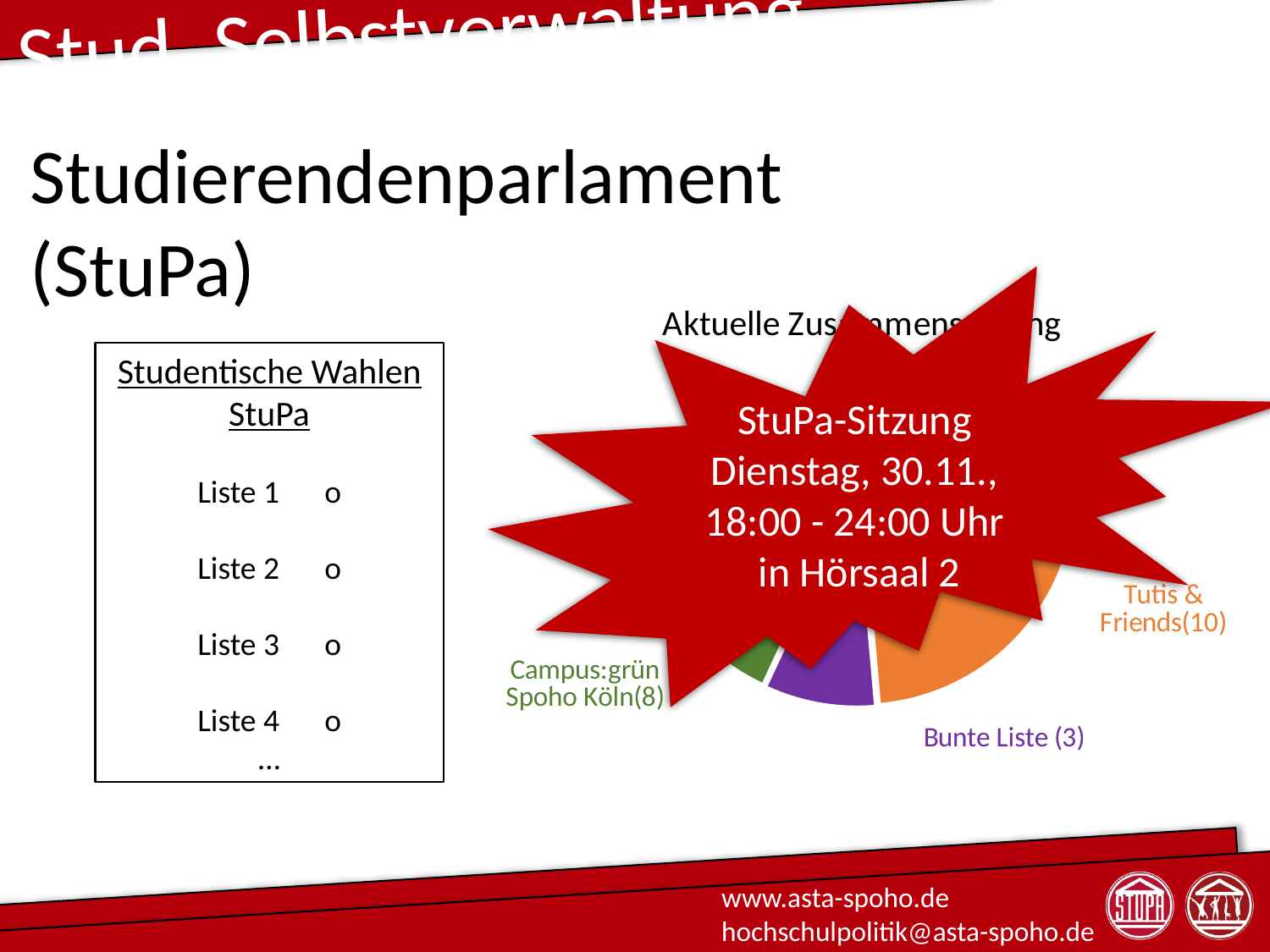
What is the difference in seats between Campus:grün Spoho Köln and Bunte Liste? 5 How many seats does the label for Tutis & Friends show? 10 Which has more seats, Tutis & Friends or Bunte Liste? Tutis & Friends Which has more seats, Campus:grün Spoho Köln or Bunte Liste? Campus:grün Spoho Köln What kind of chart is shown on the slide? doughnut chart How many seats does the label for Campus:grün Spoho Köln show? 8 What colour is the Tutis & Friends slice of the pie chart? orange What is the difference in seats between Tutis & Friends and Campus:grün Spoho Köln? 2 What is the difference in seats between Tutis & Friends and Bunte Liste? 7 Which has more seats, Tutis & Friends or Campus:grün Spoho Köln? Tutis & Friends What colour is the Bunte Liste slice of the pie chart? purple How many seats does the label for Bunte Liste show? 3